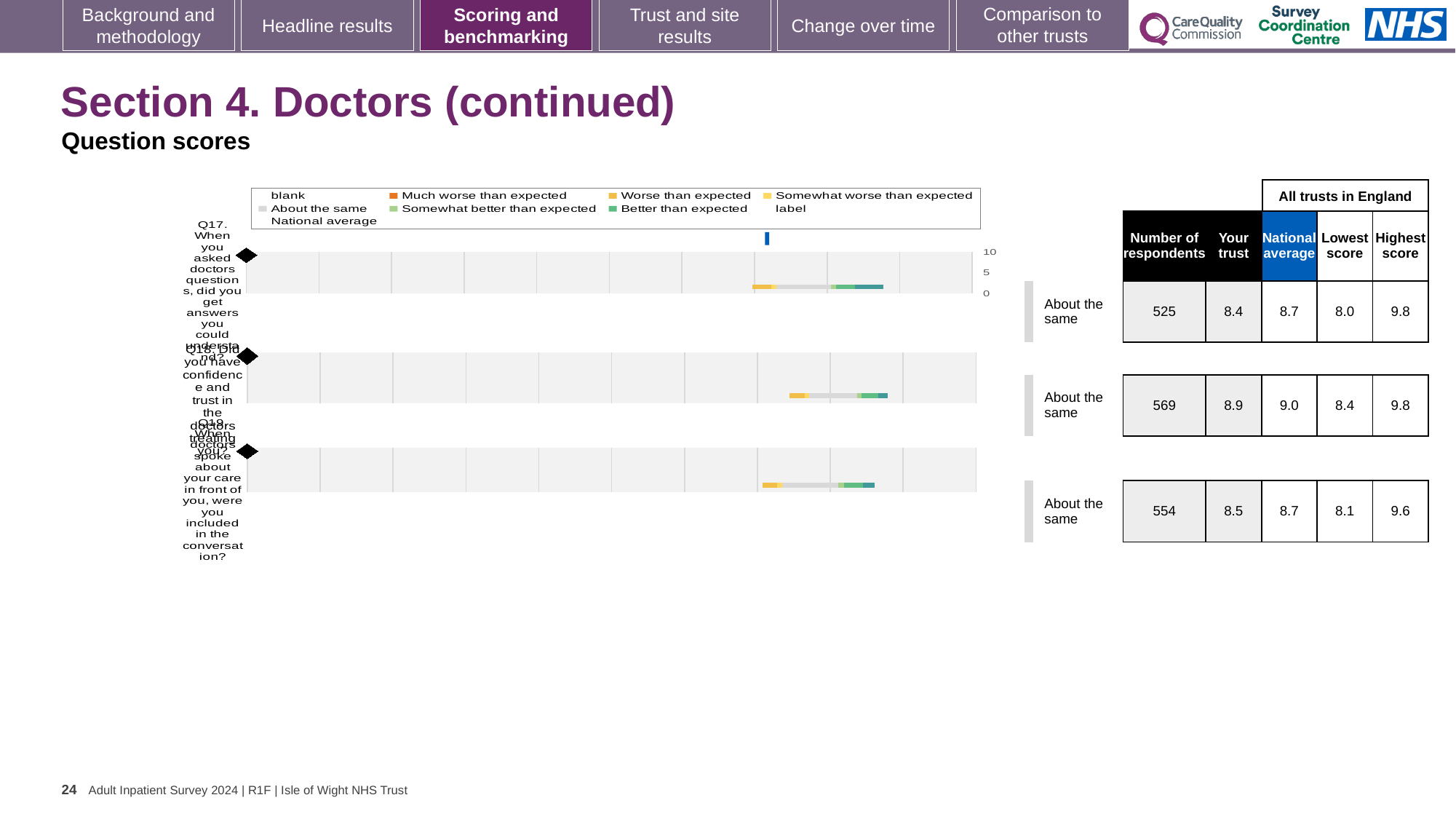
What is the national average score for Q17 (getting answers you could understand from doctors)? 8.7 What is the 'Your trust' score for Q18 (confidence and trust in the doctors treating you)? 8.9 What is the difference between the 'Your trust' scores for Q18 and Q17? 0.5 What benchmark category is shown for all three questions on the slide? About the same For Q19, which is larger: the 'Your trust' score or the national average? National average How many respondents answered Q19 (being included in the conversation when doctors spoke about your care)? 554 How many questions (categories) are plotted in the chart? 3 What is the lowest score among all trusts in England for Q18? 8.4 What kind of chart is shown on the slide? bar chart Which question has the highest 'Your trust' score? Q18 Which question has the lowest 'Your trust' score? Q17 What is the highest score among all trusts in England for Q19? 9.6